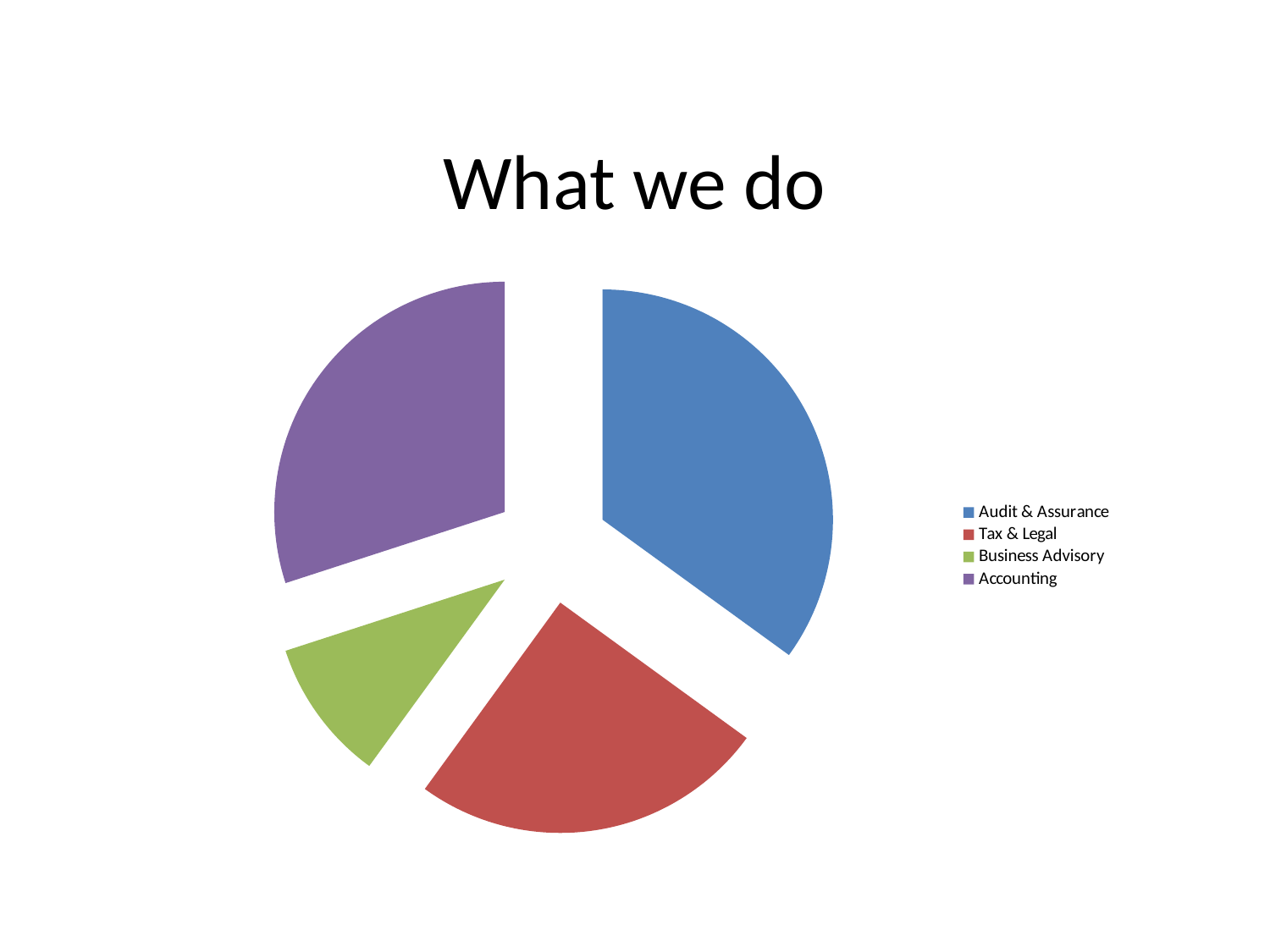
Which category has the largest slice of the pie chart? Audit & Assurance Which slice is larger, Audit & Assurance or Business Advisory? Audit & Assurance How many slices does the pie chart have? 4 Which category is shown in blue in the pie chart? Audit & Assurance What is the title of the chart? What we do What kind of chart is shown on the slide? pie chart Which slice is larger, Tax & Legal or Business Advisory? Tax & Legal Which category has the smallest slice of the pie chart? Business Advisory Which slice is larger, Accounting or Business Advisory? Accounting